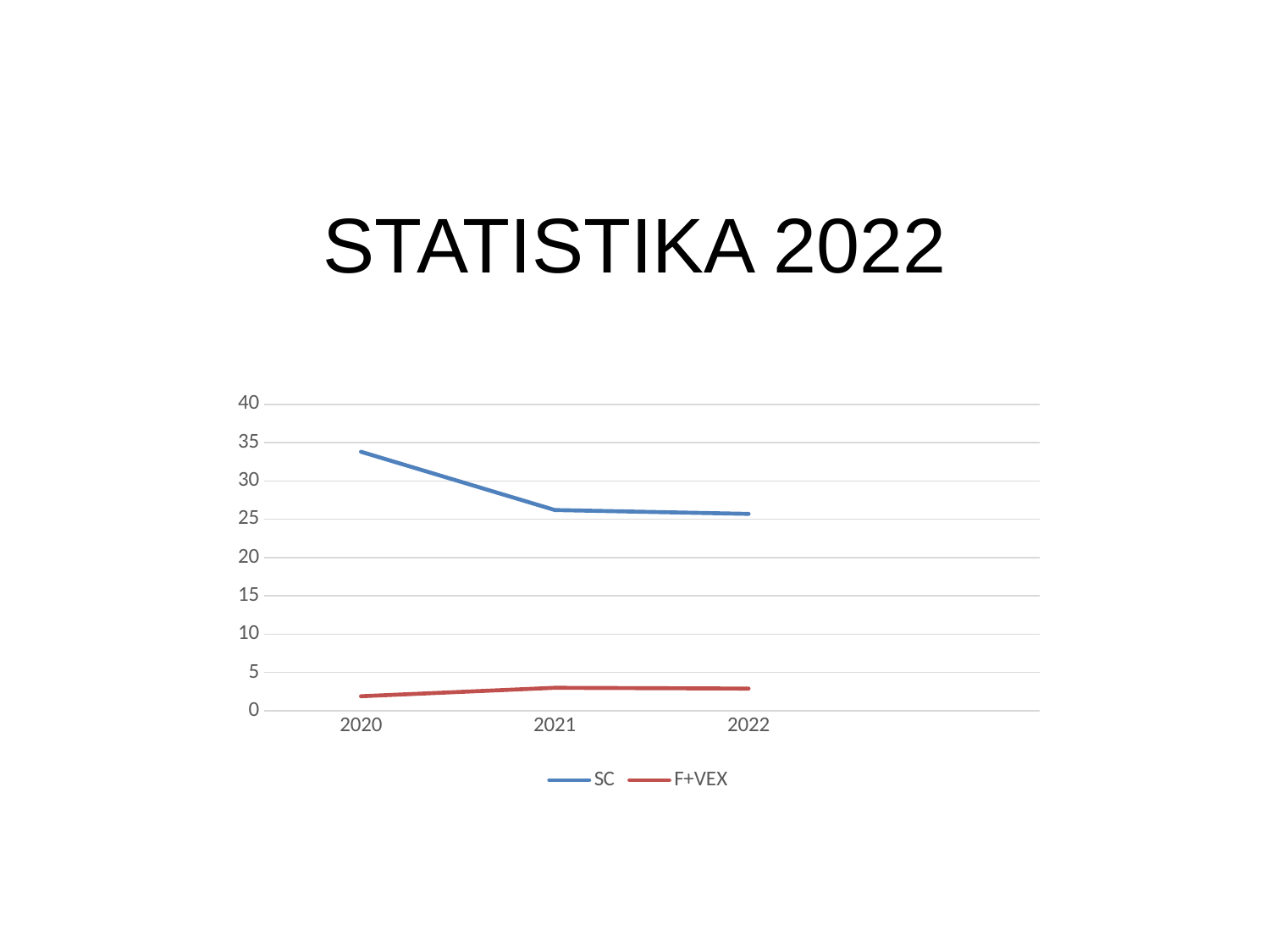
How many years are plotted on the x axis? 3 In which year is the SC value highest? 2020 Does the SC line rise or fall from 2020 to 2022? fall Is the F+VEX value for 2022 greater or less than 5? less How many series does the legend list? 2 What kind of chart is shown on the slide? line chart Is the SC value for 2021 greater or less than 20? greater Which series has the higher value in 2021, SC or F+VEX? SC Which series does the blue line represent? SC Is the SC value for 2020 greater or less than 30? greater What is the title of the slide? STATISTIKA 2022